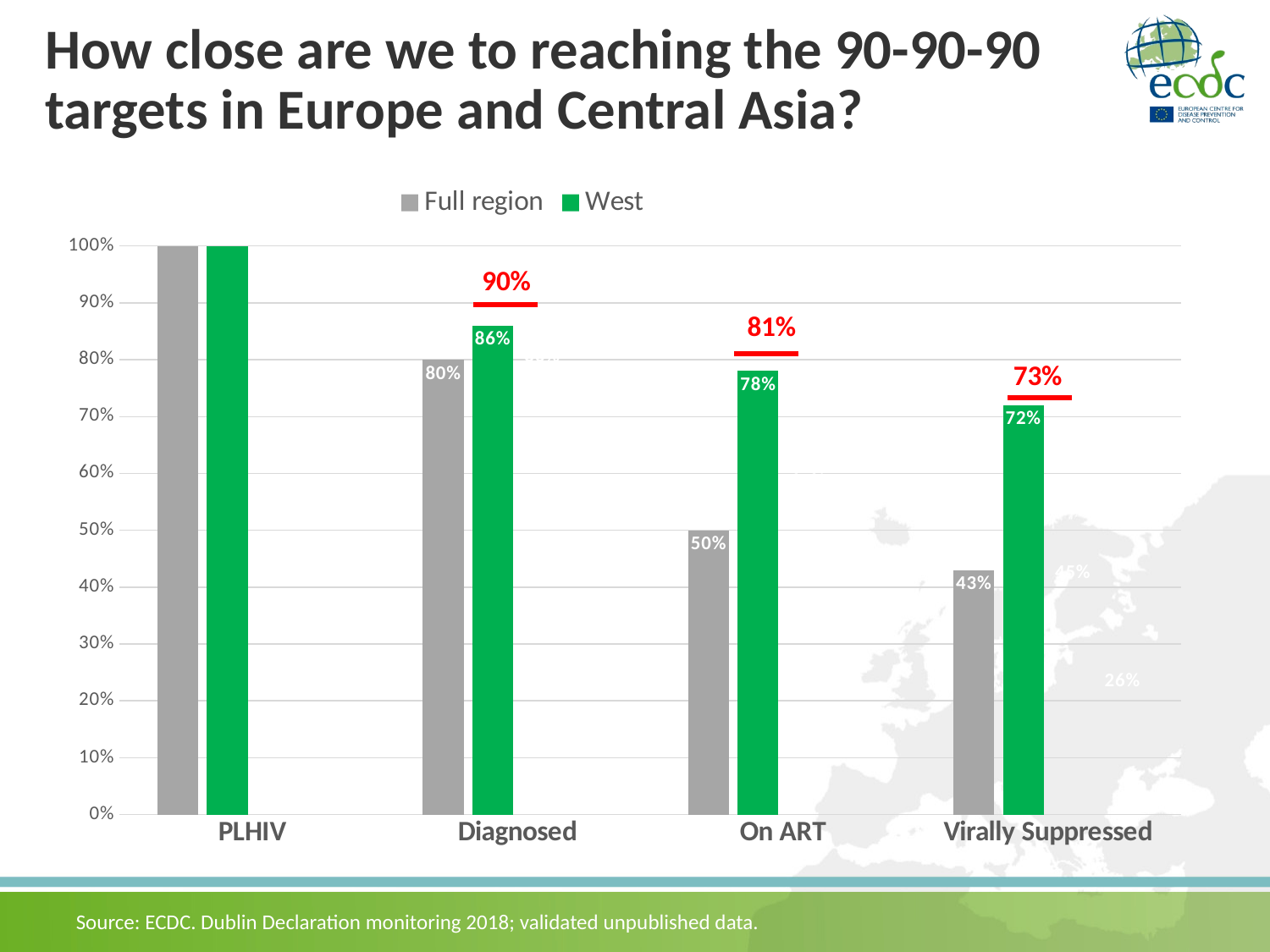
Which is larger for Diagnosed: the Full region value or the West value? West What red target value is marked above the Virally Suppressed bars? 73% Is the Full region value for On ART greater or less than 60%? less How many categories are shown on the x axis? 4 How many series does the legend list? 2 What is the Full region value for Virally Suppressed? 43% What is the Full region value for Diagnosed? 80% What is the West value for Virally Suppressed? 72% What is the West value for On ART? 78% What kind of chart is shown on the slide? bar chart Which category has the lowest Full region value? Virally Suppressed What is the difference between the West and Full region values for On ART? 28%